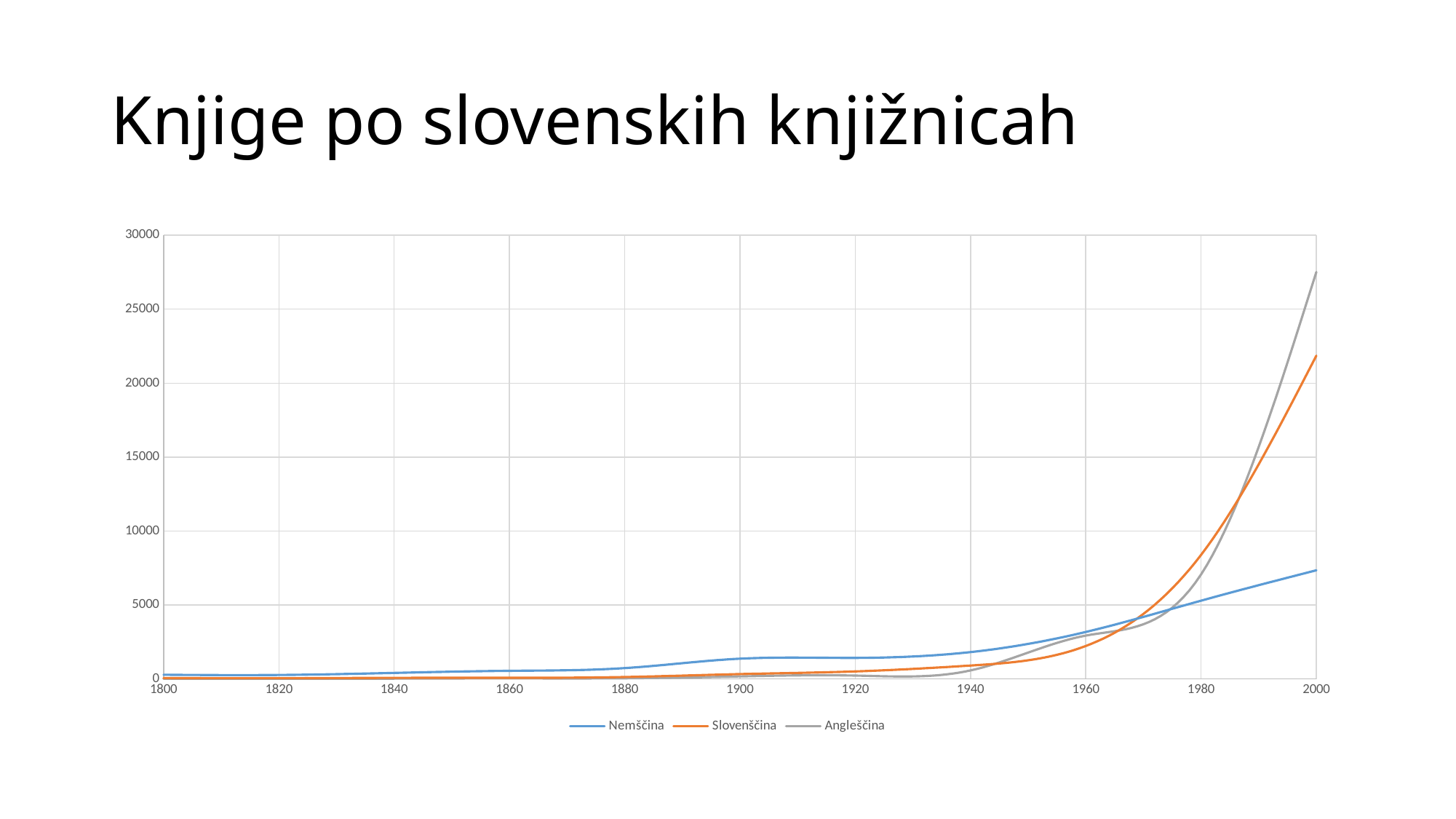
Is the value for Nemščina at 2000 greater or less than 10000? less What is the title of the slide containing the chart? Knjige po slovenskih knjižnicah Is the value for Slovenščina at 2000 greater or less than 20000? greater Is the value for Nemščina at 1960 greater or less than 5000? less Which series has the highest value at 2000? Angleščina At 1900, which series has the larger value, Nemščina or Slovenščina? Nemščina Which series has the lowest value at 2000? Nemščina Does the Angleščina line rise or fall between 1960 and 2000? rise What are the series names listed in the legend? Nemščina, Slovenščina, Angleščina What kind of chart is shown on the slide? line chart How many series does the legend list? 3